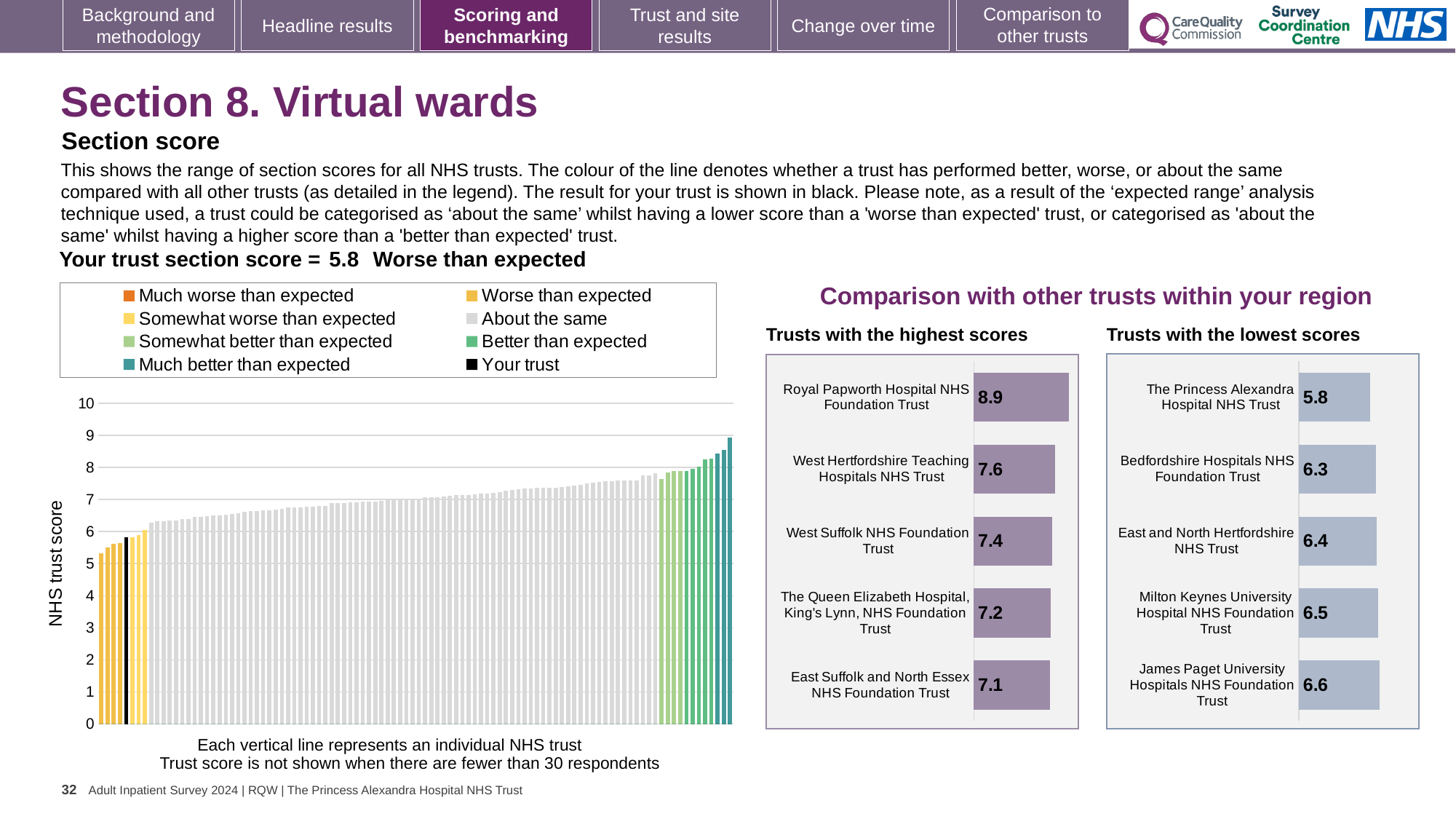
In the 'Trusts with the lowest scores' chart, what is the difference between the scores of James Paget University Hospitals NHS Foundation Trust and The Princess Alexandra Hospital NHS Trust? 0.8 In the 'Trusts with the lowest scores' chart, which trust has the lowest score? The Princess Alexandra Hospital NHS Trust In the 'Trusts with the lowest scores' chart, which has the higher score: Milton Keynes University Hospital NHS Foundation Trust or East and North Hertfordshire NHS Trust? Milton Keynes University Hospital NHS Foundation Trust In the 'Trusts with the highest scores' chart, which trust has the highest score? Royal Papworth Hospital NHS Foundation Trust In the 'Trusts with the highest scores' chart, what is the score for West Suffolk NHS Foundation Trust? 7.4 In the 'Trusts with the highest scores' chart, what is the difference between the scores of Royal Papworth Hospital NHS Foundation Trust and West Hertfordshire Teaching Hospitals NHS Trust? 1.3 What kind of chart is the 'NHS trust score' chart on the left of the slide? Bar chart In the 'NHS trust score' chart on the left, do the bar values rise or fall from left to right? Rise How many trusts are shown in the 'Trusts with the highest scores' chart? 5 How many entries does the legend of the 'NHS trust score' chart on the left list? 8 In the 'Trusts with the highest scores' chart, what is the score for Royal Papworth Hospital NHS Foundation Trust? 8.9 In the 'Trusts with the lowest scores' chart, what is the score for Bedfordshire Hospitals NHS Foundation Trust? 6.3